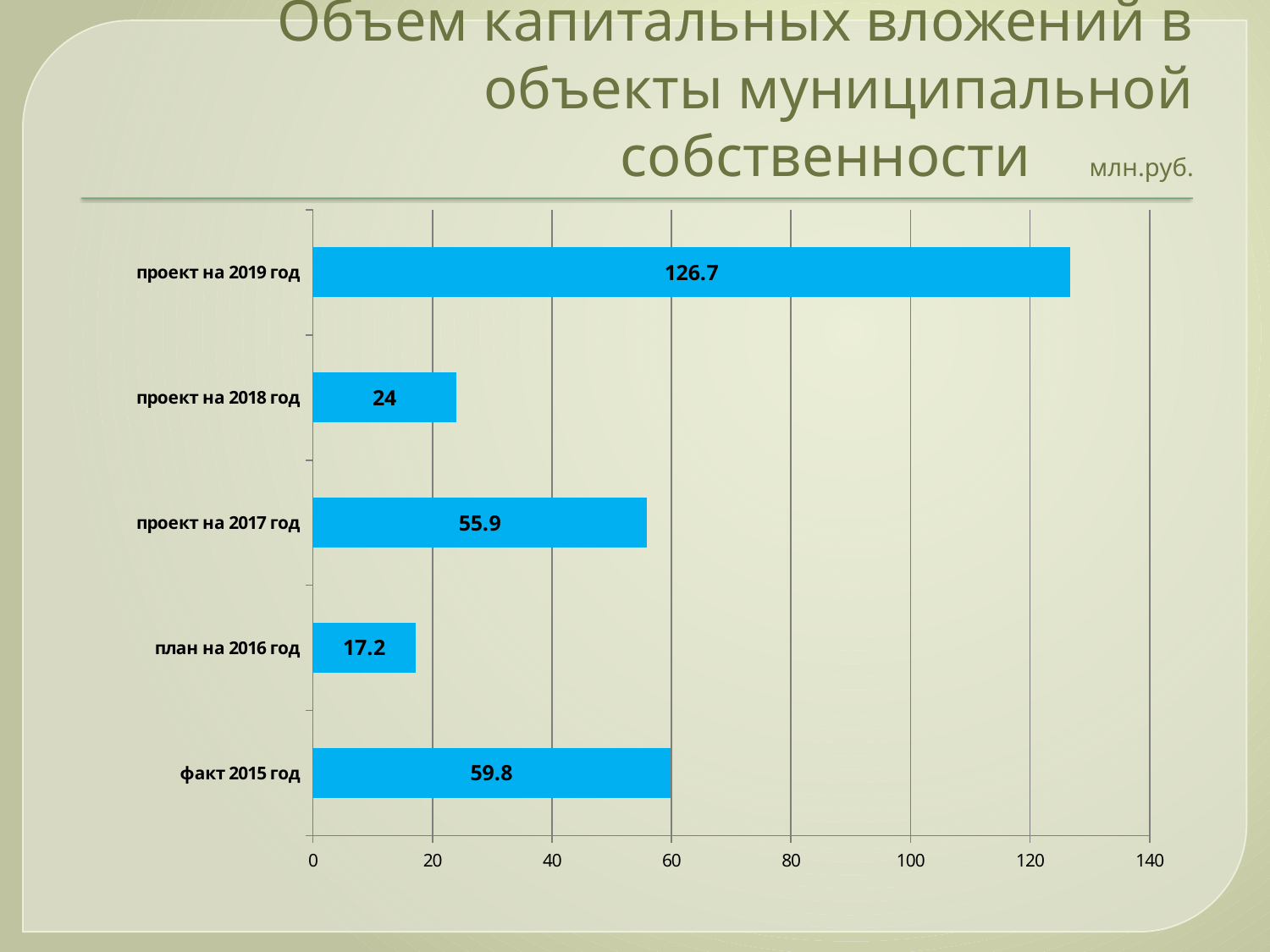
Which category has the highest value? проект на 2019 год What is the value for проект на 2019 год? 126.7 What is the difference between the values for проект на 2019 год and проект на 2018 год? 102.7 What kind of chart is shown on the slide? bar chart What is the value for проект на 2018 год? 24 How many categories are shown in the chart? 5 Which is larger, the value for факт 2015 год or проект на 2017 год? факт 2015 год What is the value for факт 2015 год? 59.8 Which category has the lowest value? план на 2016 год What is the value for план на 2016 год? 17.2 What unit is indicated next to the chart title? млн.руб. Is the value for проект на 2019 год greater or less than 120? greater